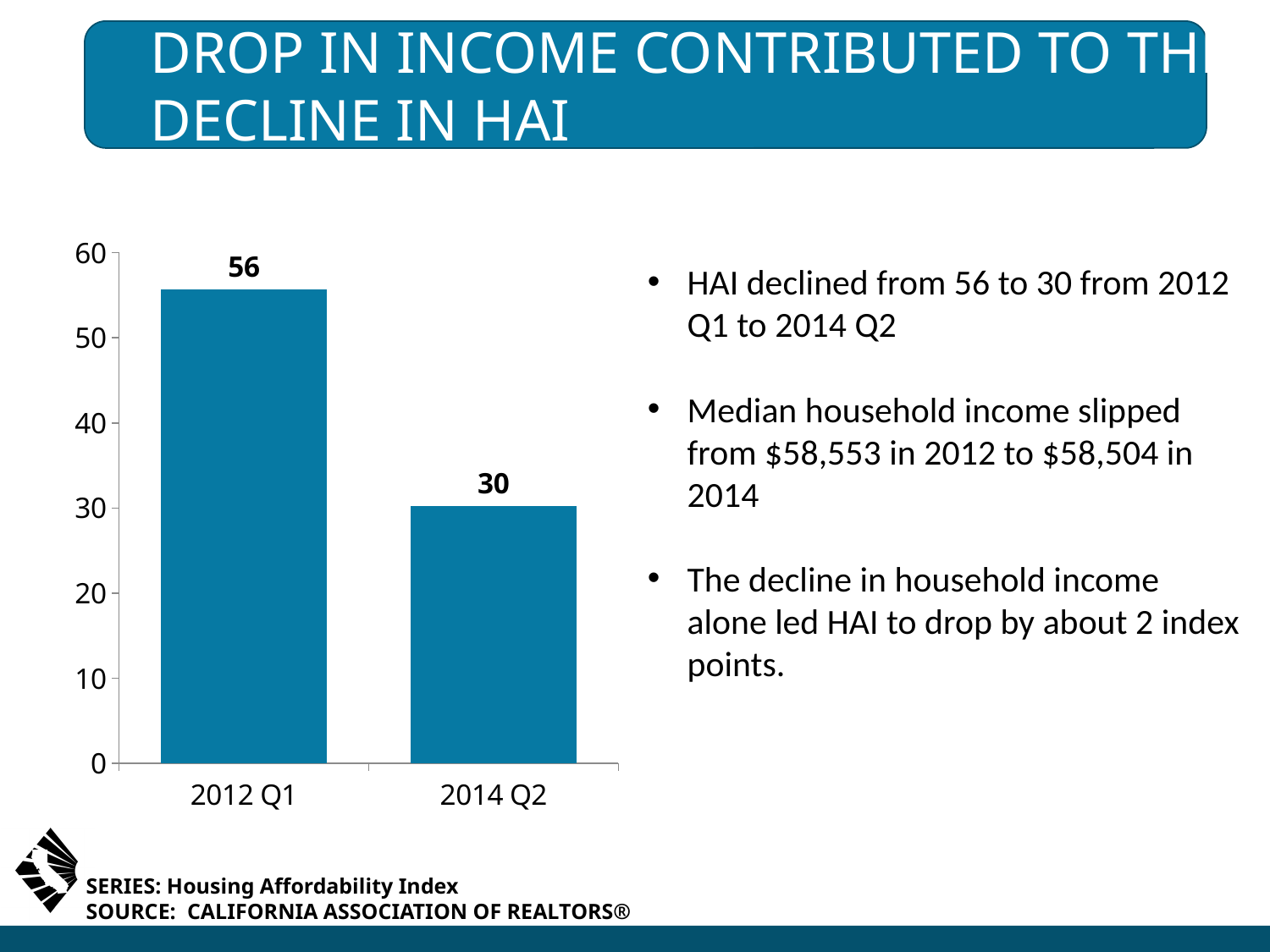
What kind of chart is shown on the slide? bar chart What is the value for 2014 Q2? 30 Is the value for 2014 Q2 greater or less than 40? less Do the values rise or fall from 2012 Q1 to 2014 Q2? fall What is the value for 2012 Q1? 56 How many categories are shown on the x axis? 2 Which is larger, the value for 2012 Q1 or the value for 2014 Q2? 2012 Q1 Which category has the lowest value? 2014 Q2 Which category has the highest value? 2012 Q1 What is the highest value shown on the y axis? 60 What is the difference between the values for 2012 Q1 and 2014 Q2? 26 Is the value for 2012 Q1 greater or less than 50? greater